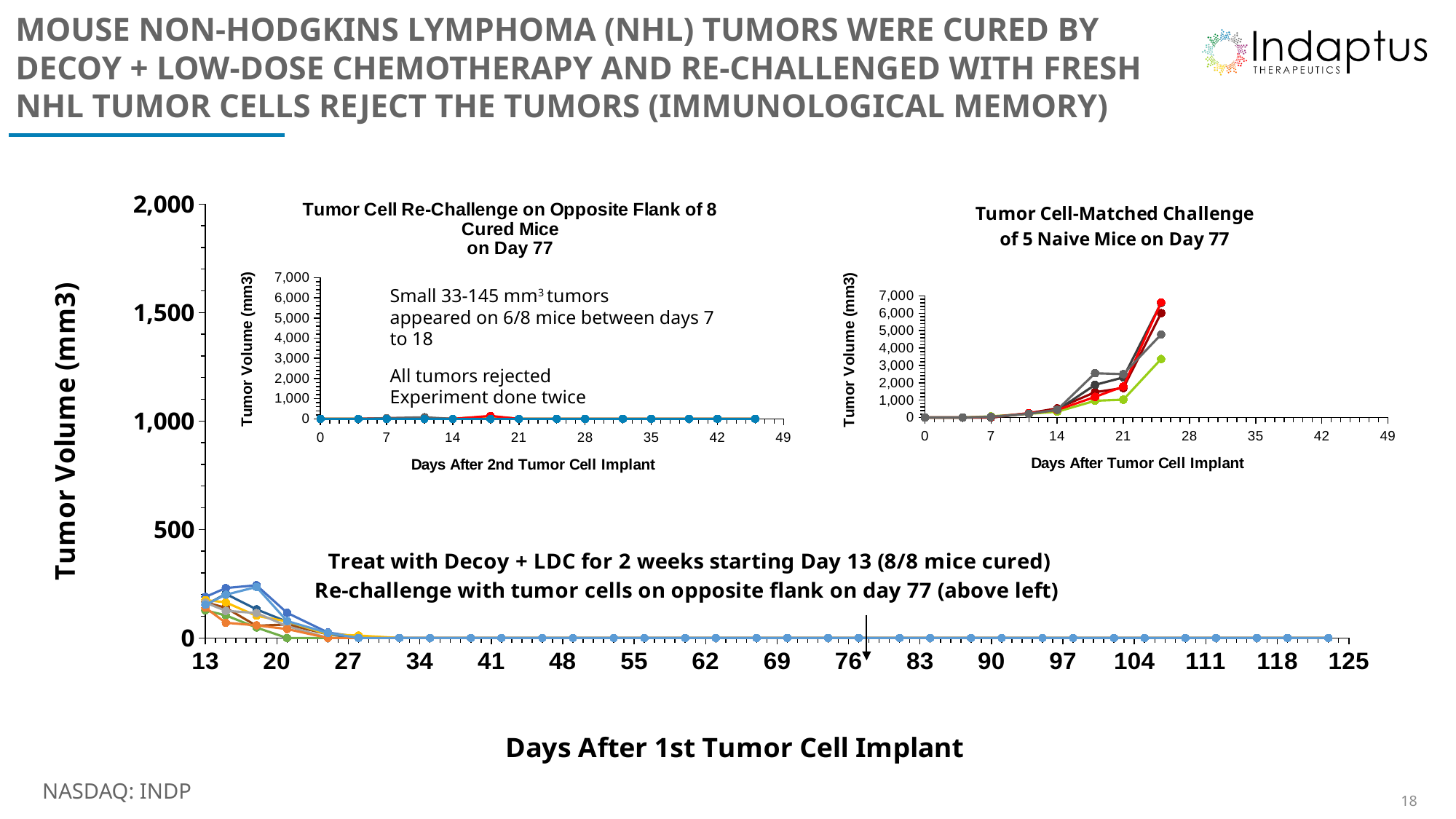
In the chart 'Tumor Cell Re-Challenge on Opposite Flank of 8 Cured Mice on Day 77', are the tumor volumes after day 21 greater or less than 1,000 mm3? Less In the large bottom chart, do the tumor volume values rise or fall as days after 1st tumor cell implant increase? Fall What kind of chart is 'Tumor Cell-Matched Challenge of 5 Naive Mice on Day 77'? Line chart In the chart 'Tumor Cell-Matched Challenge of 5 Naive Mice on Day 77', are the tumor volumes at day 14 greater or less than 2,000 mm3? Less In the large bottom chart, what is the highest value shown on the y axis? 2,000 In the chart 'Tumor Cell-Matched Challenge of 5 Naive Mice on Day 77', do the tumor volumes rise or fall as days after tumor cell implant increase? Rise In the large bottom chart, what is the last tick label on the x axis? 125 In the chart 'Tumor Cell-Matched Challenge of 5 Naive Mice on Day 77', is the highest plotted tumor volume greater or less than 5,000 mm3? Greater What is the x-axis title of the chart 'Tumor Cell Re-Challenge on Opposite Flank of 8 Cured Mice on Day 77'? Days After 2nd Tumor Cell Implant What kind of chart is the large chart titled 'Days After 1st Tumor Cell Implant' on the x axis? Line chart